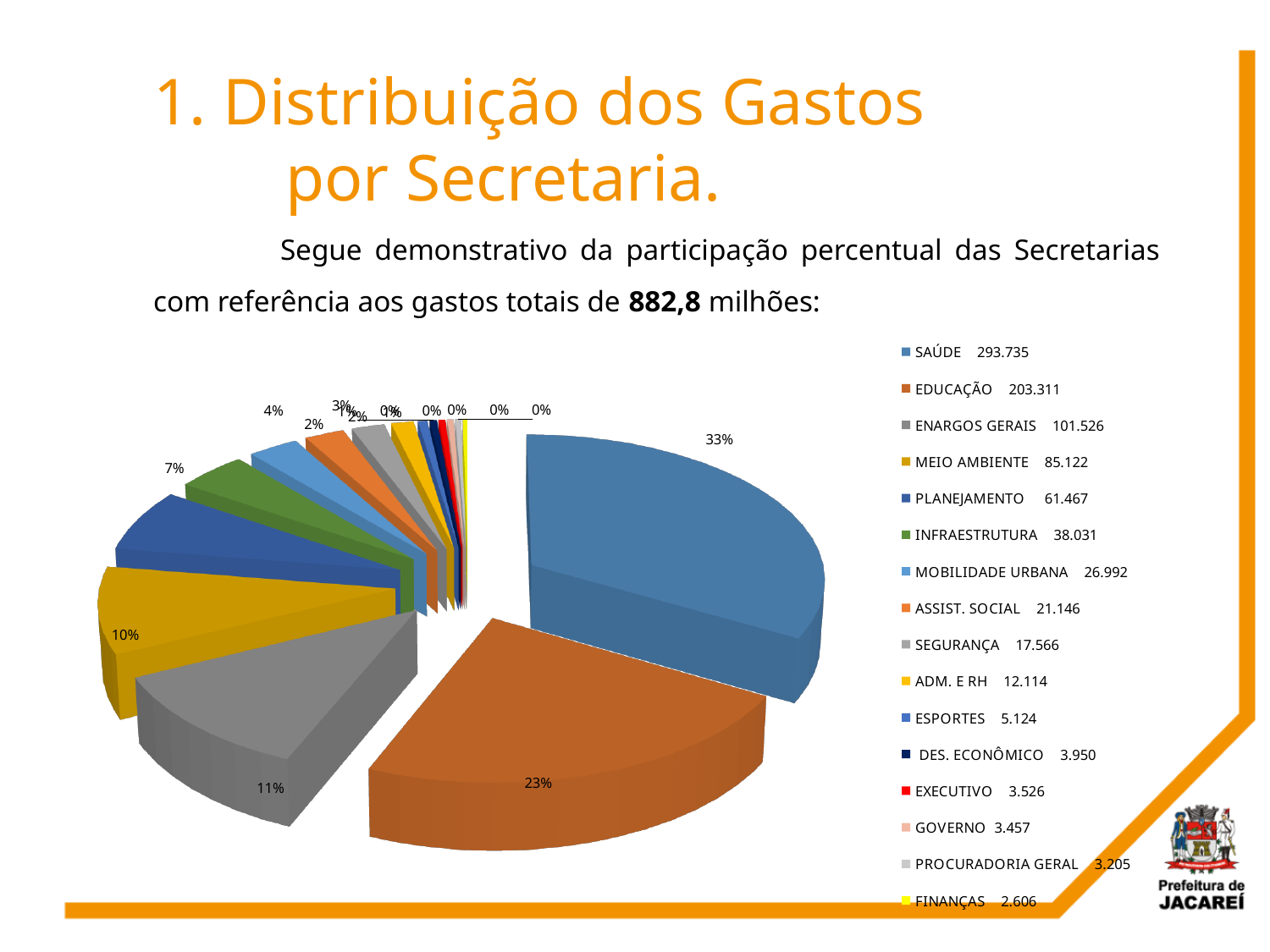
What is the difference between the values for SAÚDE and EDUCAÇÃO? 90.424 Which category has the smallest value in the legend? FINANÇAS Which is larger, the value for PLANEJAMENTO or the value for INFRAESTRUTURA? PLANEJAMENTO What is the value shown for SAÚDE in the legend? 293.735 What is the value shown for MEIO AMBIENTE in the legend? 85.122 What share of the pie does the EDUCAÇÃO slice represent? 23% What is the value shown for EDUCAÇÃO in the legend? 203.311 Which category has the largest slice of the pie? SAÚDE What kind of chart is shown on the slide? pie chart What is the value shown for SEGURANÇA in the legend? 17.566 How many categories does the legend list? 16 What share of the pie does the SAÚDE slice represent? 33%